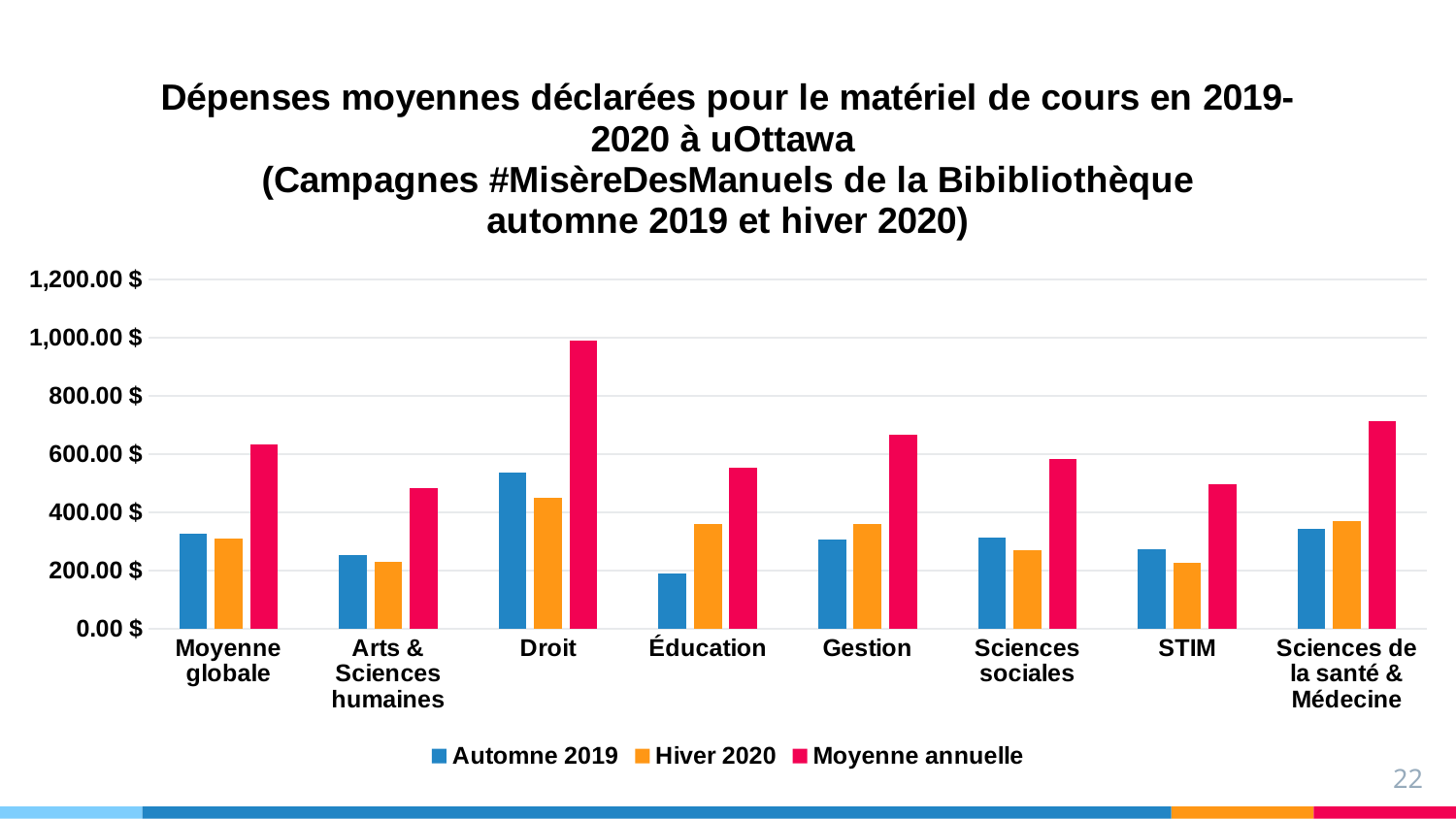
Is the Moyenne annuelle value for Droit greater or less than 800.00 $? greater Is the Automne 2019 value for Éducation greater or less than 200.00 $? less Which category has the highest Moyenne annuelle value? Droit Which category has the lowest Automne 2019 value? Éducation What are the three series listed in the legend? Automne 2019, Hiver 2020, Moyenne annuelle How many categories are shown along the x axis? 8 Is the Moyenne annuelle value for Sciences de la santé & Médecine greater or less than 600.00 $? greater For Éducation, which is larger: the Automne 2019 value or the Hiver 2020 value? Hiver 2020 How many series does the legend list? 3 Which category has the highest Hiver 2020 value? Droit For Droit, which is larger: the Automne 2019 value or the Hiver 2020 value? Automne 2019 What kind of chart is shown on the slide? Bar chart